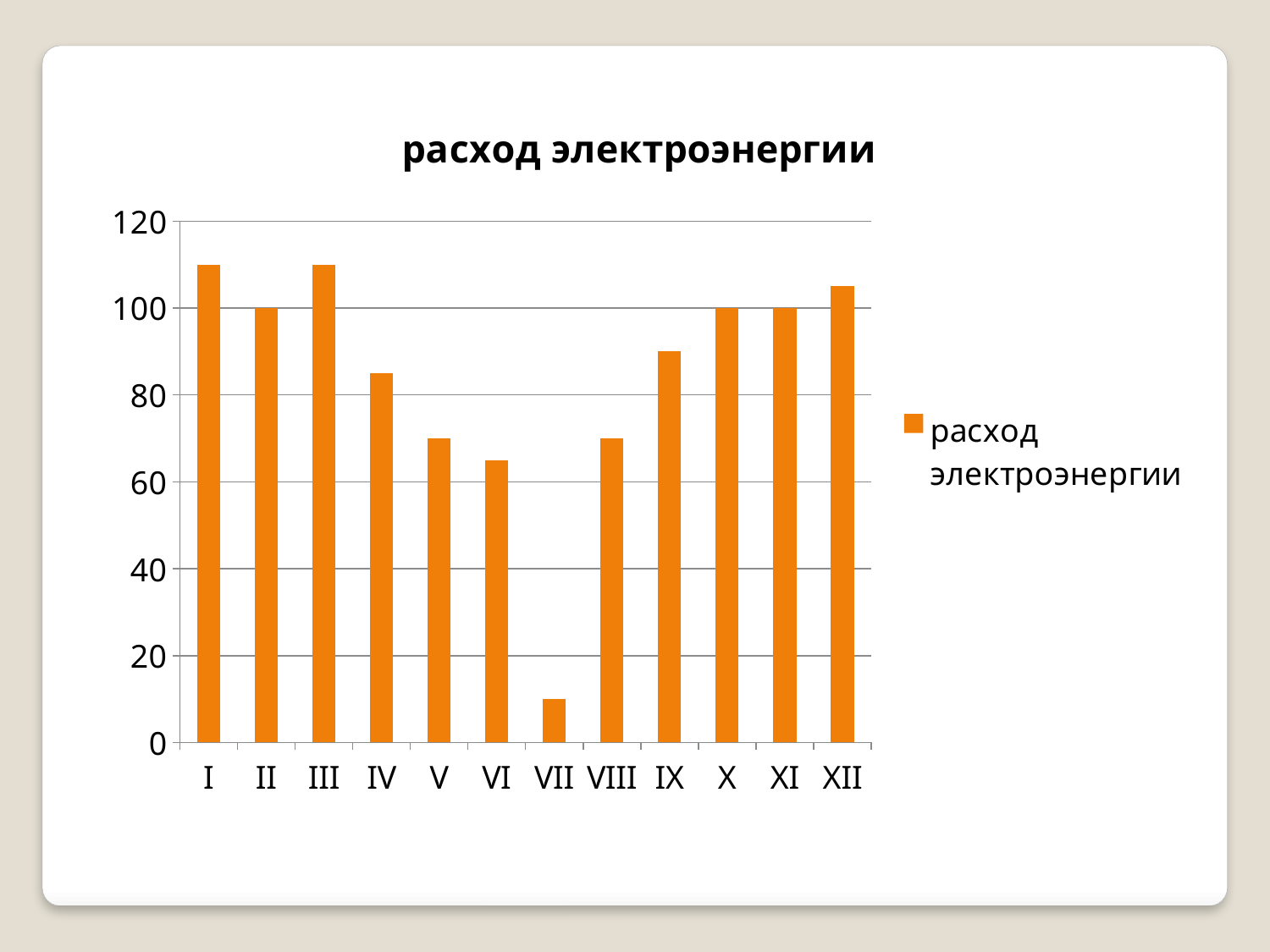
What is the title of the chart? расход электроэнергии Is the value for category I greater or less than 100? greater Which is larger, the value for category IV or the value for category V? IV Do the values rise or fall from category VII to category XII? rise Is the value for category VII greater or less than 20? less What kind of chart is shown on the slide? bar chart What is the value for category X? 100 How many categories are shown on the x axis? 12 Which category has the lowest value? VII How many series does the legend list? 1 What is the value for category II? 100 Is the value for category VI greater or less than 80? less